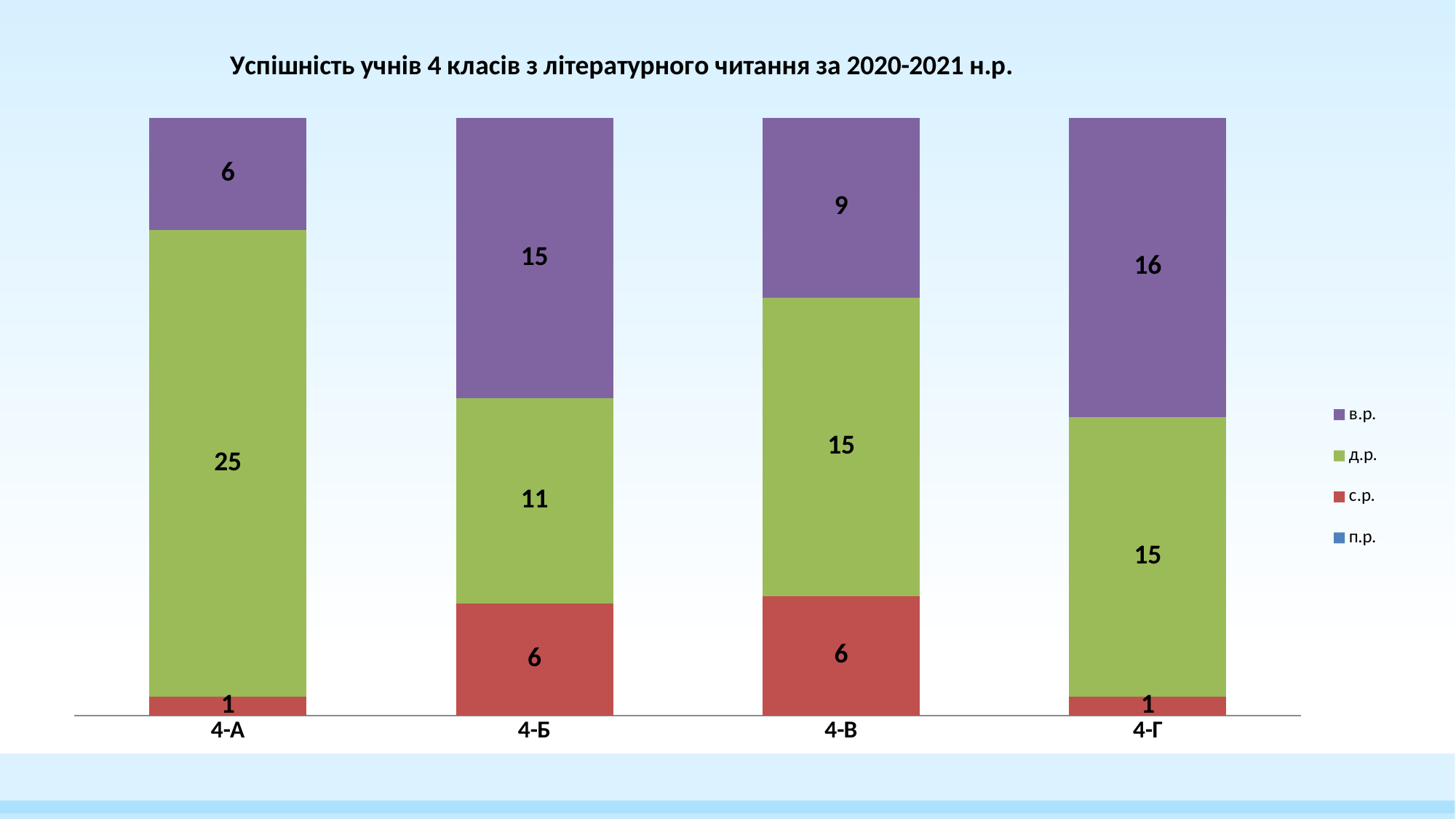
What is the value of в.р. for class 4-Б? 15 What is the value of д.р. for class 4-А? 25 What is the value of с.р. for class 4-В? 6 What is the difference between the д.р. values of 4-А and 4-Б? 14 Which is larger: the в.р. value for 4-В or the в.р. value for 4-Б? 4-Б What type of chart is shown on the slide? stacked bar chart How many series does the legend list? 4 How many classes (categories) are shown on the x axis? 4 What is the total of the labelled segments in the bar for class 4-Б? 32 Which class has the highest в.р. value? 4-Г What is the value of в.р. for class 4-Г? 16 Which class has the lowest в.р. value? 4-А